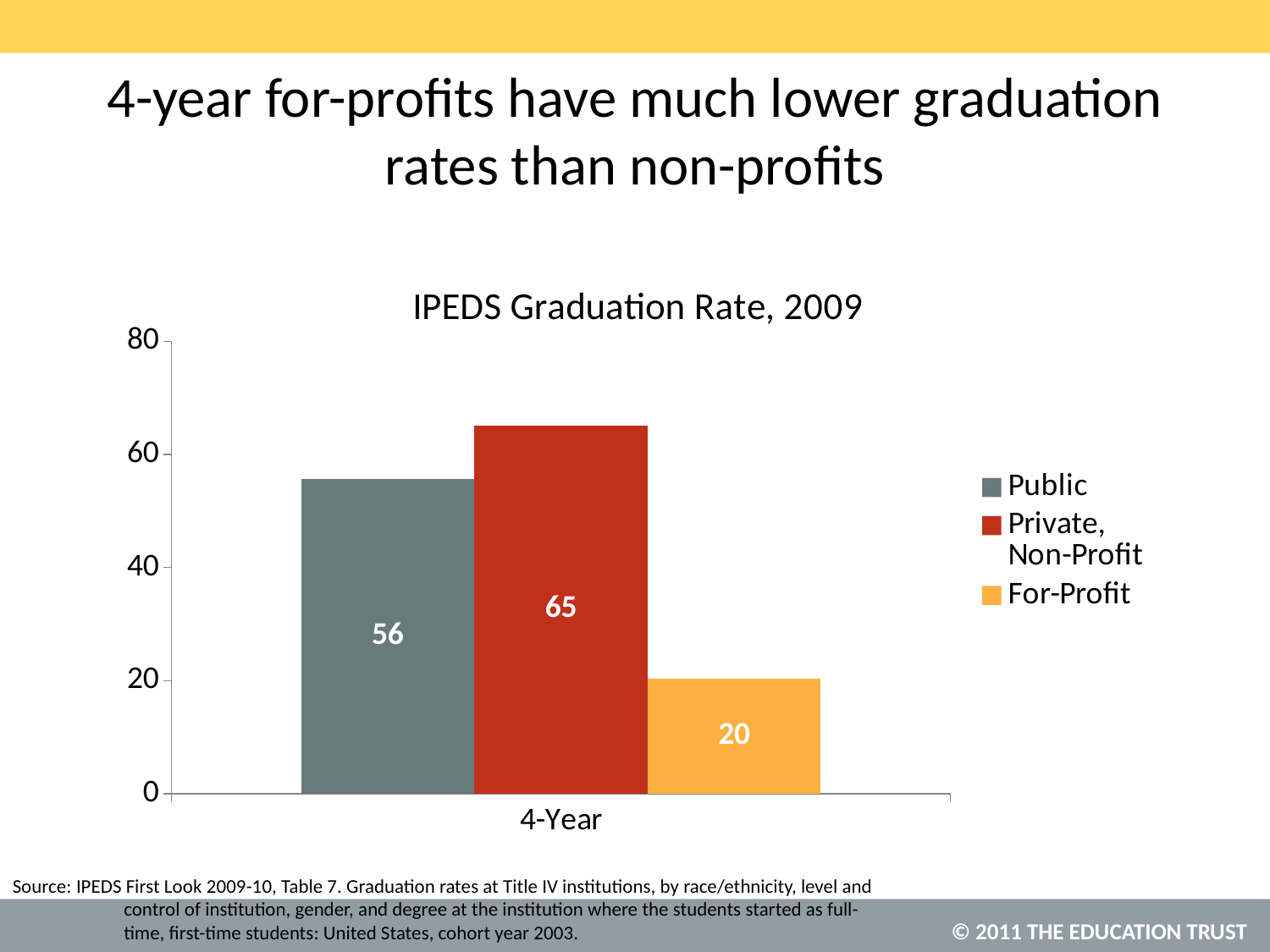
What is the graduation rate for Private, Non-Profit institutions? 65 What is the difference between the Private, Non-Profit and For-Profit graduation rates? 45 What is the graduation rate for For-Profit institutions? 20 How many series does the legend list? 3 What is the title of the chart? IPEDS Graduation Rate, 2009 Which series has the lowest graduation rate? For-Profit Which series has the highest graduation rate? Private, Non-Profit What kind of chart is shown on the slide? Bar chart What is the difference between the Private, Non-Profit and Public graduation rates? 9 Is the value for Public greater or less than 60? less What is the graduation rate for Public institutions? 56 Which is larger, the graduation rate for Public or for For-Profit institutions? Public